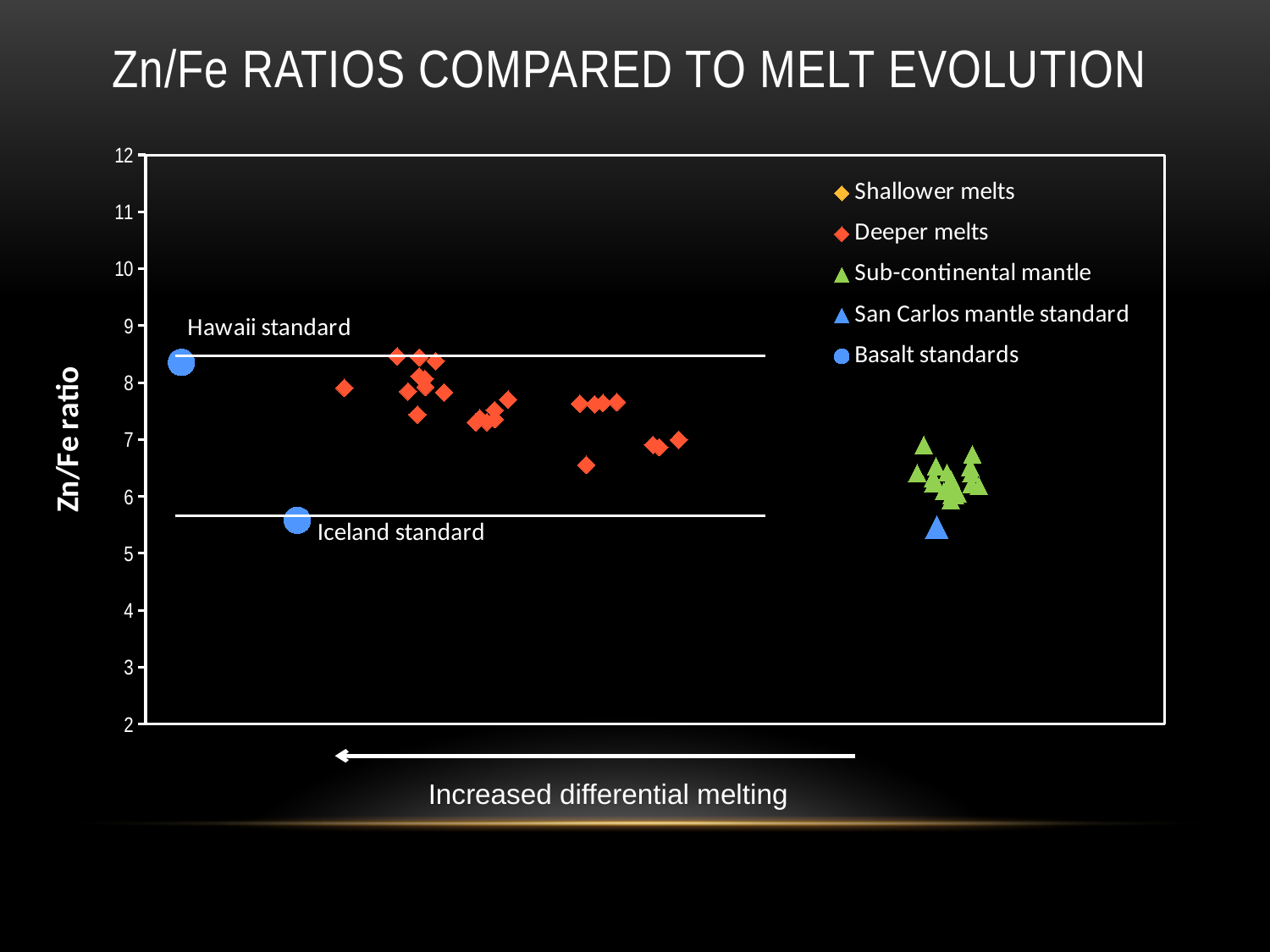
What is the label on the vertical axis? Zn/Fe ratio How many series does the legend list? 5 Is the Zn/Fe ratio of the Iceland standard greater or less than 6? less Are all the Deeper melts points plotted above or below a Zn/Fe ratio of 9? below Which has the higher Zn/Fe ratio, the Hawaii standard or the Iceland standard? Hawaii standard What kind of chart is shown on the slide? scatter chart What is the title of the chart? Zn/Fe ratios compared to melt evolution What is the highest value shown on the vertical axis? 12 Is the Zn/Fe ratio of the San Carlos mantle standard greater or less than 6? less Which has the higher Zn/Fe ratio, the Hawaii standard or the San Carlos mantle standard? Hawaii standard